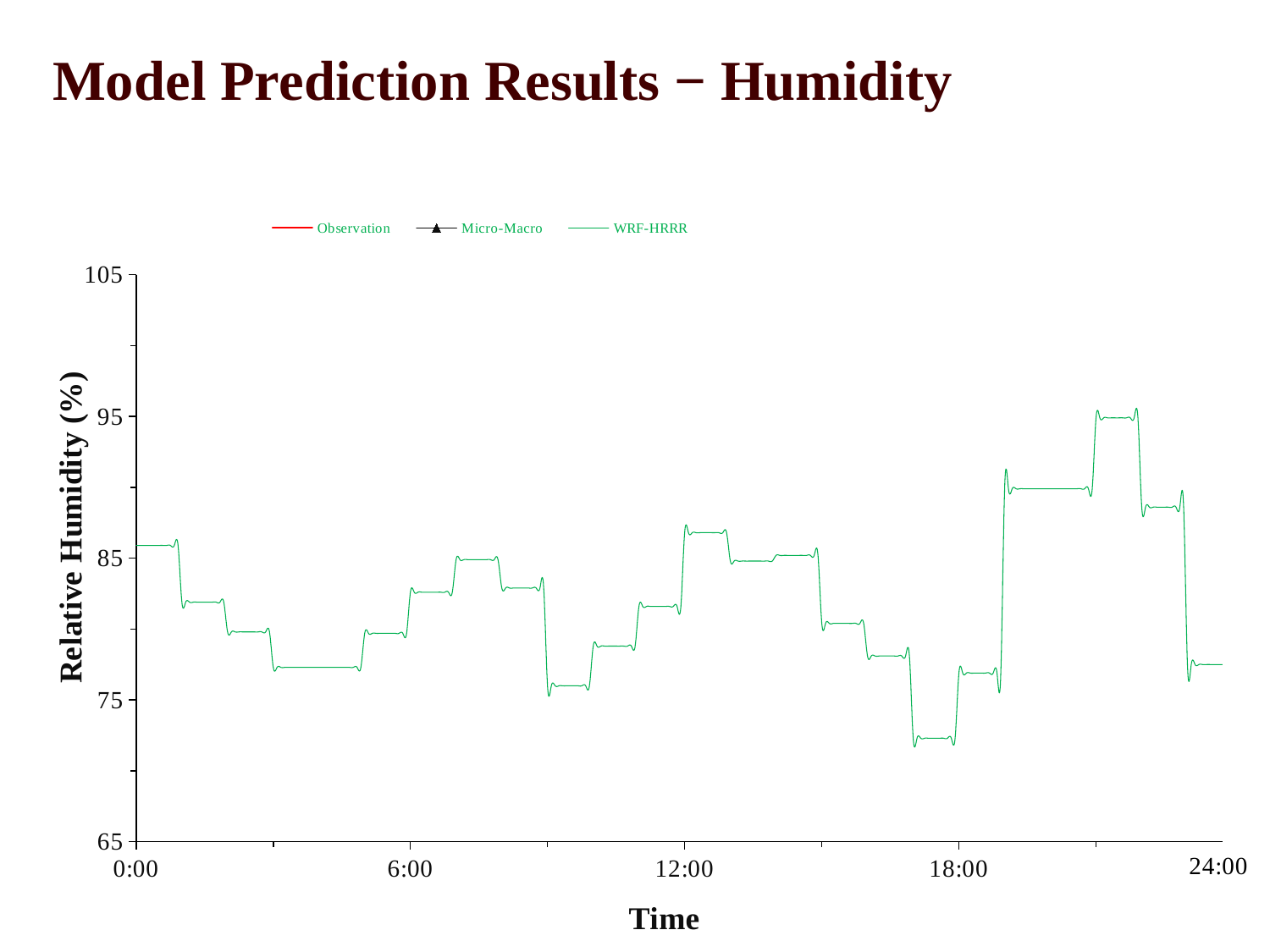
What kind of chart is shown on the slide? line chart Is the value of the plotted line at 4:00 greater or less than 85? less What is the title of the chart on the slide? Model Prediction Results – Humidity What is the label of the vertical axis? Relative Humidity (%) How many series does the legend list? 3 Between 18:00 and 21:00, does the plotted line rise or fall? rise Is the value of the plotted line at 18:00 greater or less than 85? less Between which two labelled times on the x axis does the plotted line reach its highest value? 18:00 and 24:00 Is the value of the plotted line at 6:00 greater or less than 85? less Between 12:00 and 18:00, does the plotted line rise or fall? fall